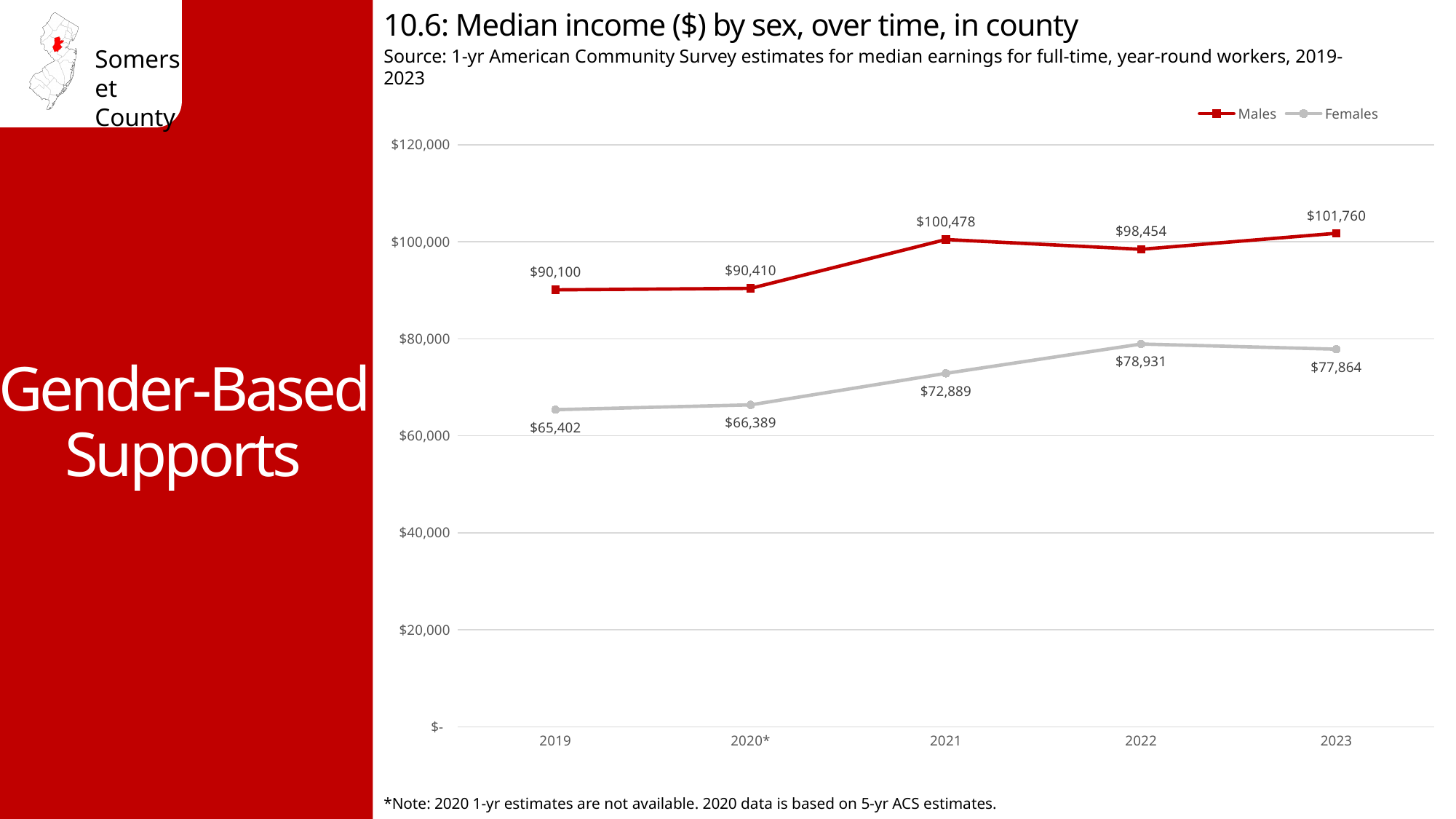
In which year was the median income for Males highest? 2023 How many series does the legend list? 2 What was the median income for Females in 2022? $78,931 Did the median income for Females rise or fall from 2019 to 2022? rise Is the median income for Females in 2021 greater or less than $80,000? less What was the median income for Males in 2021? $100,478 What was the median income for Females in 2019? $65,402 What is the difference between the Males and Females median income in 2023? $23,896 In which year was the median income for Females lowest? 2019 Which was larger in 2022: the median income for Males or for Females? Males How many years are shown on the x axis? 5 What kind of chart is shown on the slide? line chart